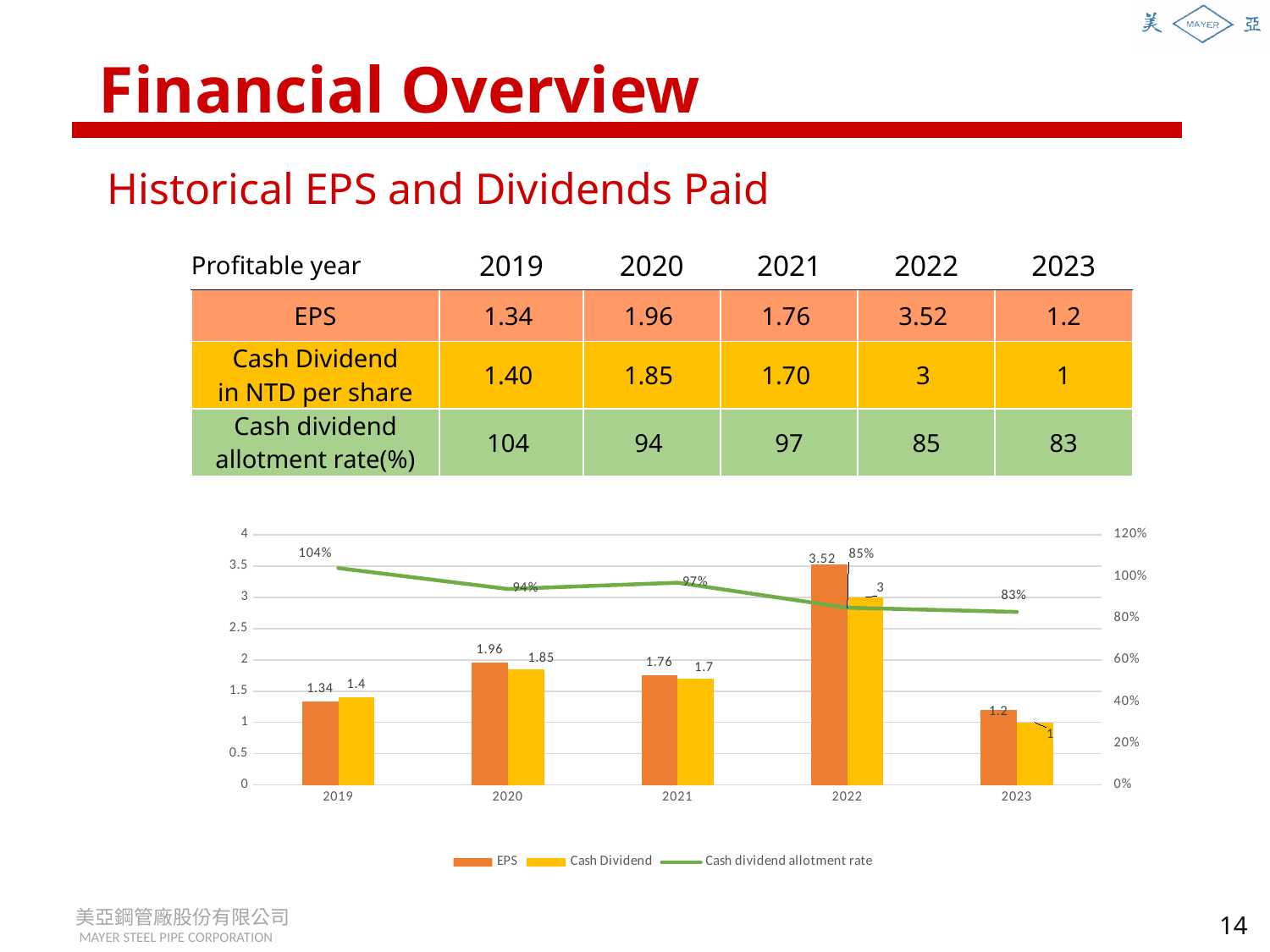
How many series does the chart legend list? 3 In 2019, which is larger: the EPS or the Cash Dividend? Cash Dividend What is the EPS value shown for 2022 in the chart? 3.52 In which year is the EPS bar highest? 2022 What is the Cash Dividend value shown for 2020 in the chart? 1.85 How many years are shown on the x axis of the chart? 5 Does the cash dividend allotment rate rise or fall from 2021 to 2023? Fall What colour is the cash dividend allotment rate line in the chart? Green What kind of chart is shown on the slide? Bar chart with a line series What is the difference between the EPS and the Cash Dividend in 2022? 0.52 In which year is the cash dividend allotment rate lowest? 2023 What is the cash dividend allotment rate shown for 2021 in the chart? 97%